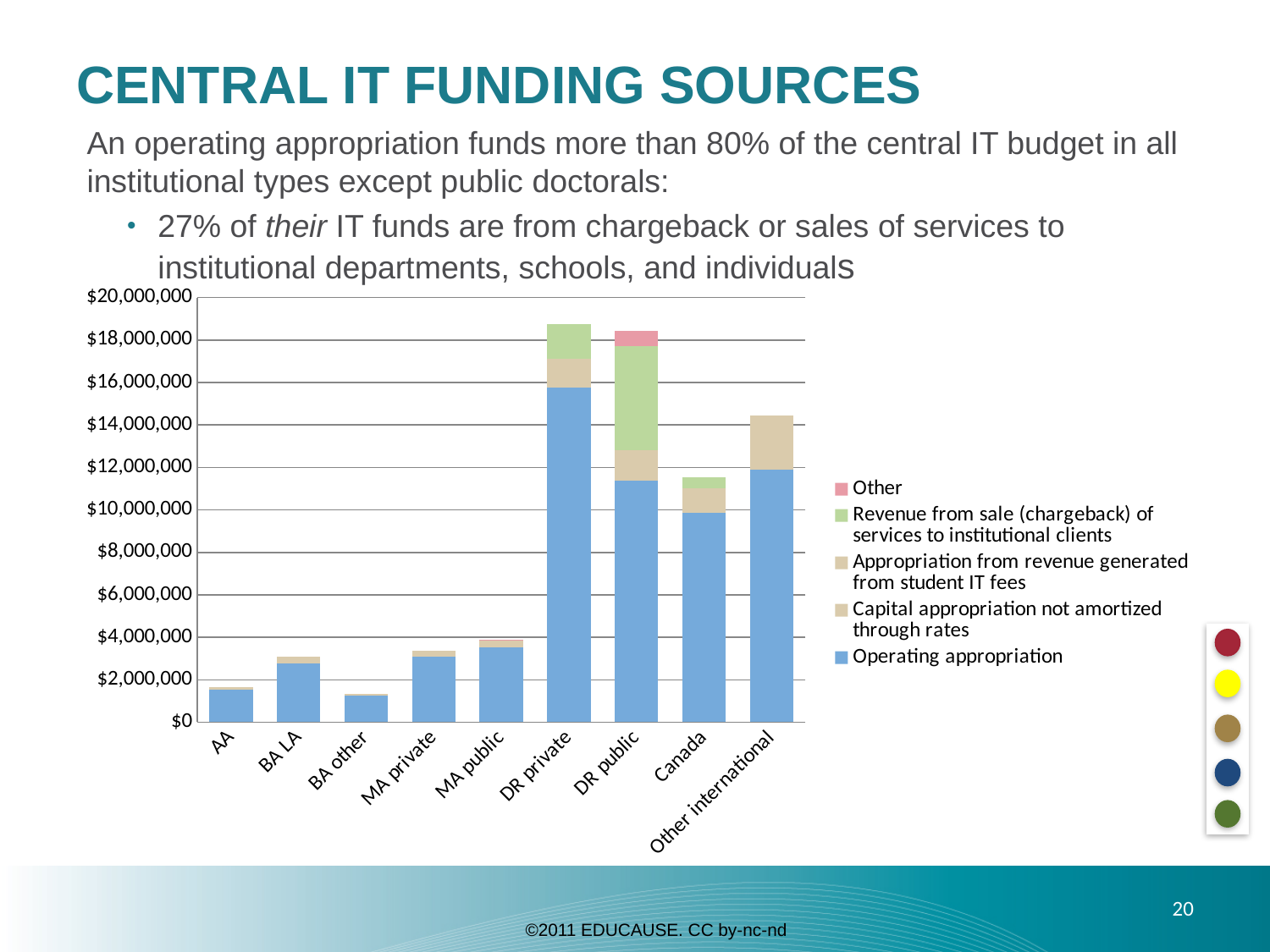
What kind of chart is shown on the slide? Stacked bar chart How many series does the chart's legend list? 5 Which series in the legend is shown in pink? Other Is the Operating appropriation segment for DR public greater or less than $10,000,000? greater Which category has the tallest total bar in the chart? DR private Is the total bar for DR private greater or less than $18,000,000? greater Is the total bar for BA other greater or less than $2,000,000? less Which has the larger total bar, AA or BA LA? BA LA Which category has the shortest total bar in the chart? BA other How many institutional categories are shown along the x axis of the chart? 9 Which has the larger total bar, Canada or Other international? Other international